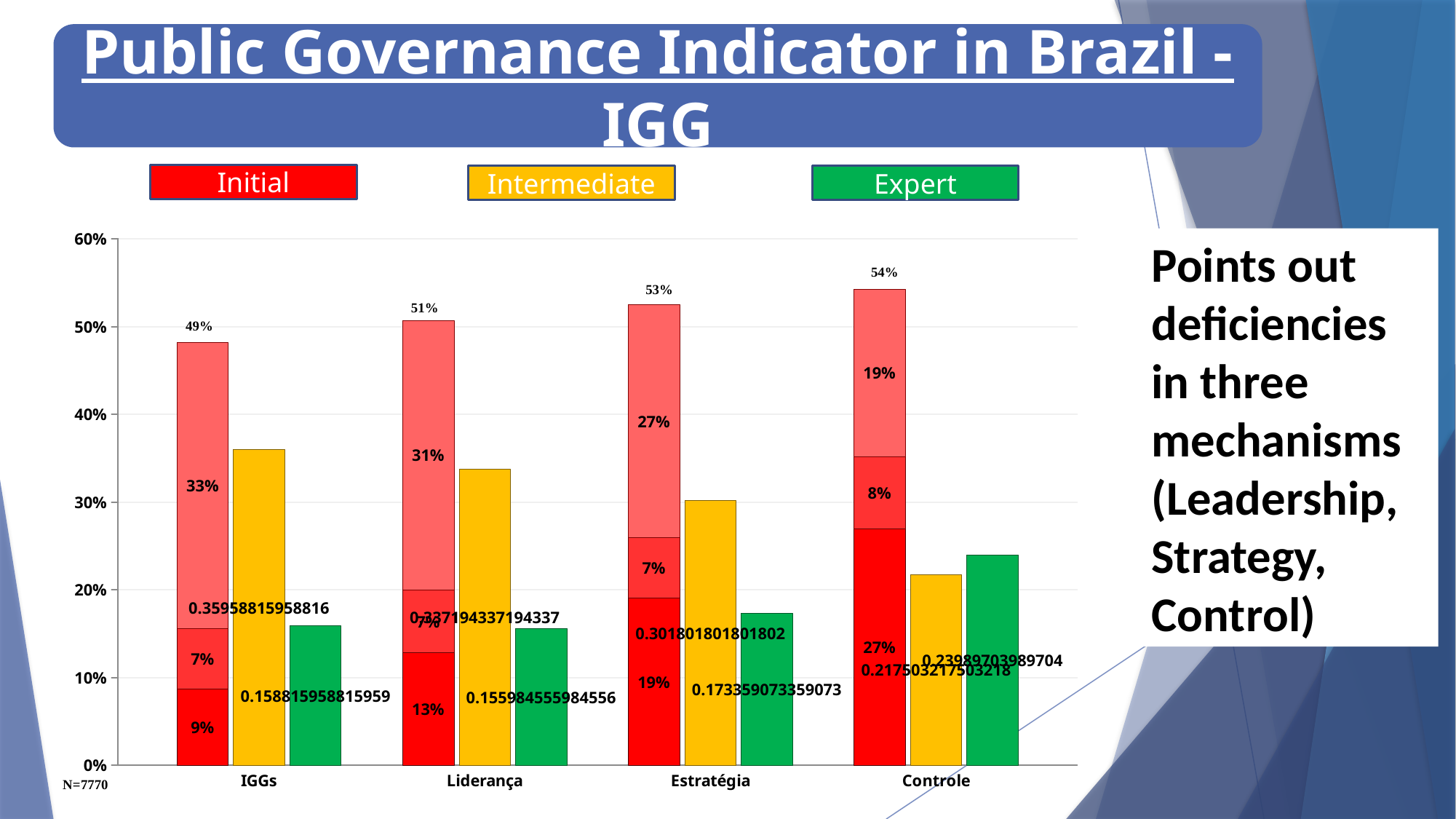
What is the value of the middle segment of the Initial (red) stacked bar for Controle? 8% How many series does the legend list? 3 What is the value of the top segment of the Initial (red) stacked bar for IGGs? 33% Which category has the lowest total for the Initial (red) stacked bar? IGGs What is the difference between the Initial total for Controle and the Initial total for IGGs? 5 percentage points Is the Intermediate value for IGGs greater or less than 30%? greater What is the total value shown above the Initial (red) stacked bar for Controle? 54% For IGGs, which is larger: the Intermediate bar or the Expert bar? Intermediate What is the value of the bottom segment of the Initial (red) stacked bar for Estratégia? 19% How many categories are shown on the x axis? 4 Which category has the highest total for the Initial (red) stacked bar? Controle Do the Initial (red) bar totals rise or fall from IGGs to Controle along the x axis? rise